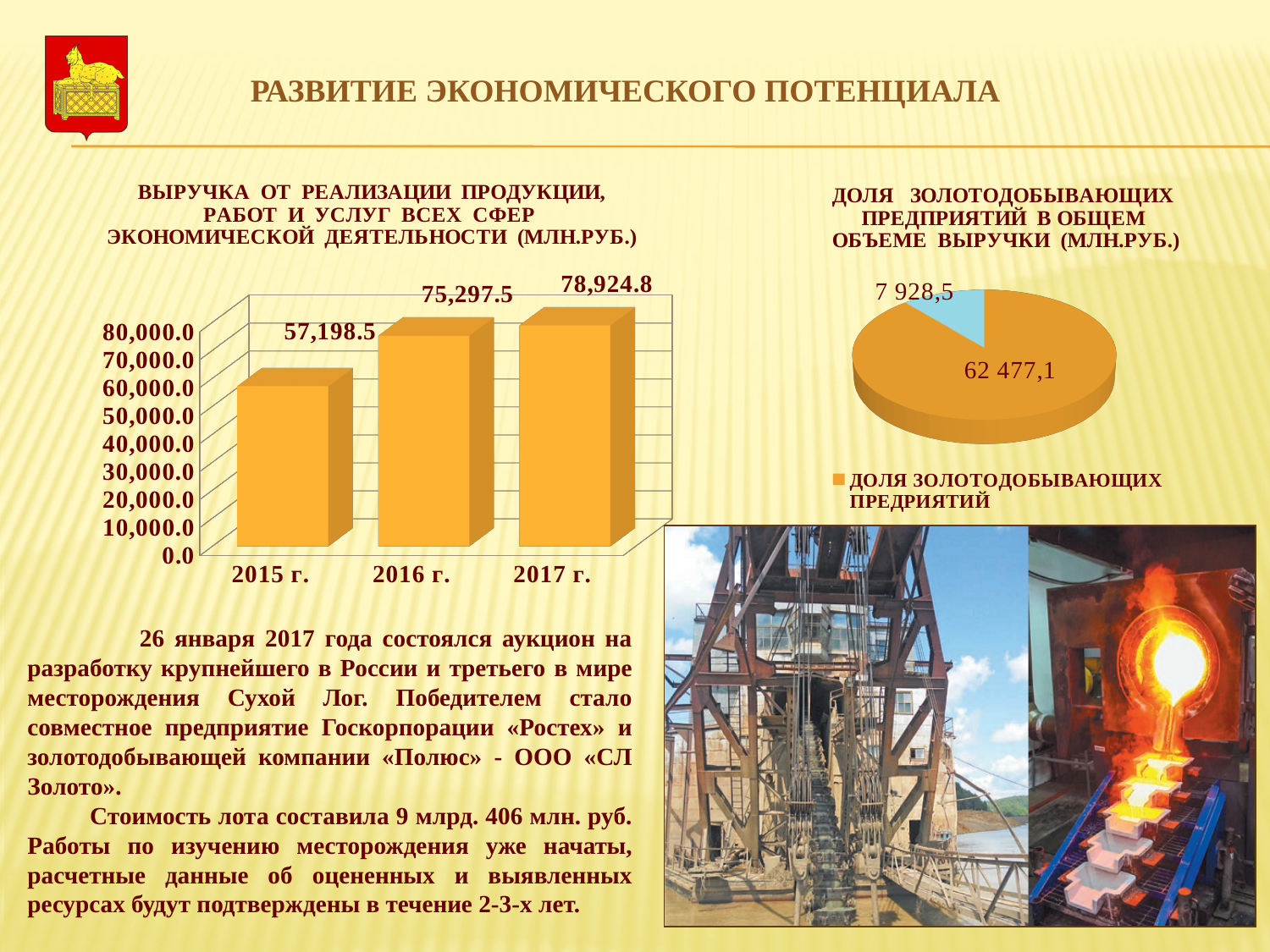
In the bar chart on the left, which year has the lowest revenue? 2015 г. In the pie chart on the right, what is the total of the two slices? 70 405,6 How many years are shown in the bar chart on the left? 3 In the bar chart on the left, what is the difference between the 2017 г. and 2015 г. values? 21,726.3 In the bar chart on the left, do the values rise or fall from 2015 г. to 2017 г.? rise In the pie chart on the right, what is the value of the smaller blue slice? 7 928,5 In the bar chart on the left, what is the revenue value for 2015 г.? 57,198.5 What type of chart is the chart on the left showing revenue by year? bar chart In the bar chart on the left, what is the revenue value for 2017 г.? 78,924.8 In the bar chart on the left, what is the revenue value for 2016 г.? 75,297.5 In the pie chart on the right, what is the value of the orange slice for gold mining enterprises (ДОЛЯ ЗОЛОТОДОБЫВАЮЩИХ ПРЕДПРИЯТИЙ)? 62 477,1 In the bar chart on the left, which year has the highest revenue? 2017 г.